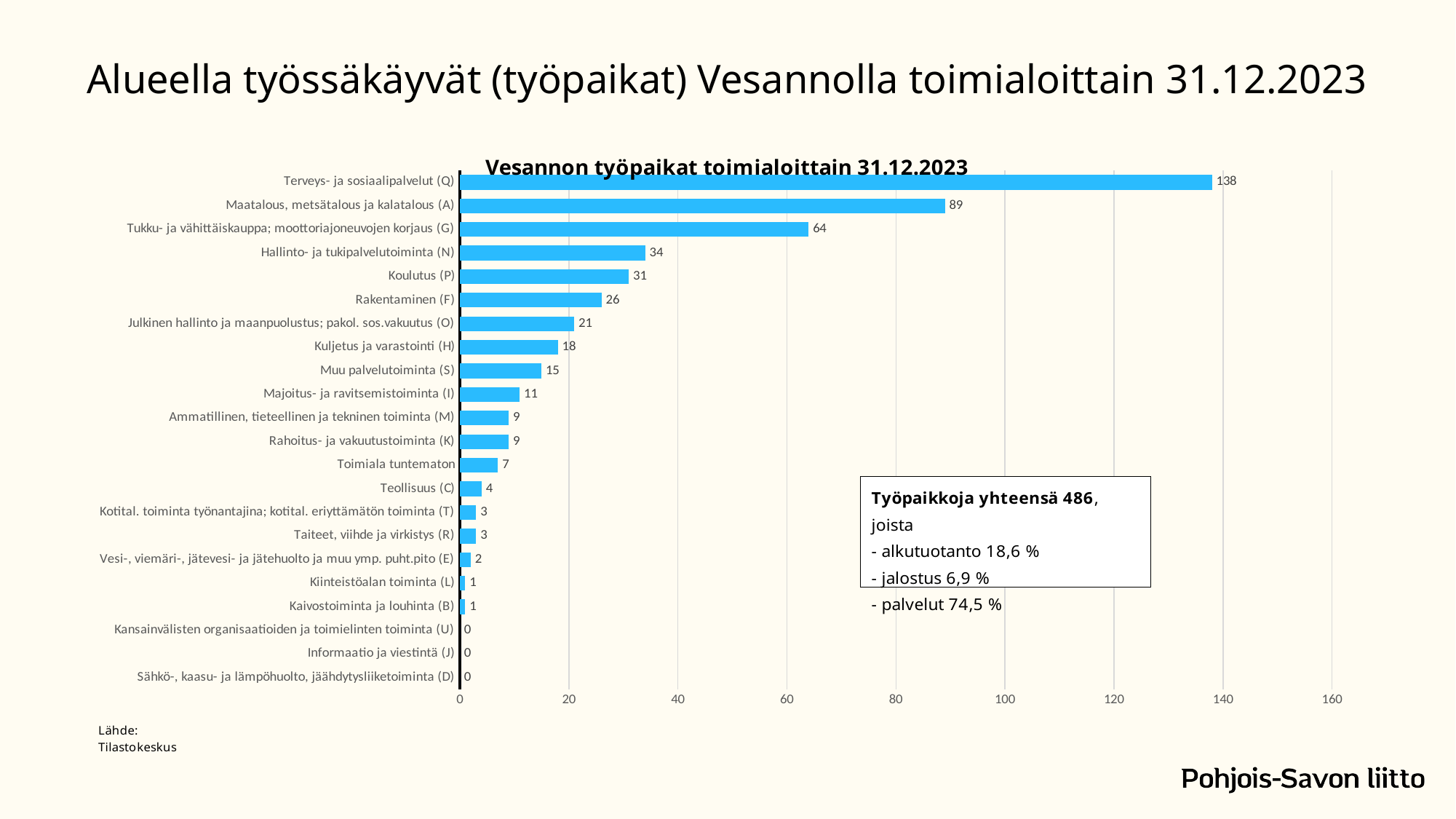
What is the difference between Hallinto- ja tukipalvelutoiminta (N) and Koulutus (P)? 3 What kind of chart is shown on the slide? bar chart What is the value for Teollisuus (C)? 4 What is the value for Tukku- ja vähittäiskauppa; moottoriajoneuvojen korjaus (G)? 64 Is the value for Maatalous, metsätalous ja kalatalous (A) greater or less than 80? greater What is the title of the chart? Vesannon työpaikat toimialoittain 31.12.2023 Which category has the highest value? Terveys- ja sosiaalipalvelut (Q) What is the difference between Terveys- ja sosiaalipalvelut (Q) and Maatalous, metsätalous ja kalatalous (A)? 49 Which is larger, Koulutus (P) or Rakentaminen (F)? Koulutus (P) What is the value for Terveys- ja sosiaalipalvelut (Q)? 138 How many categories are shown in the chart? 22 What is the value for Kuljetus ja varastointi (H)? 18